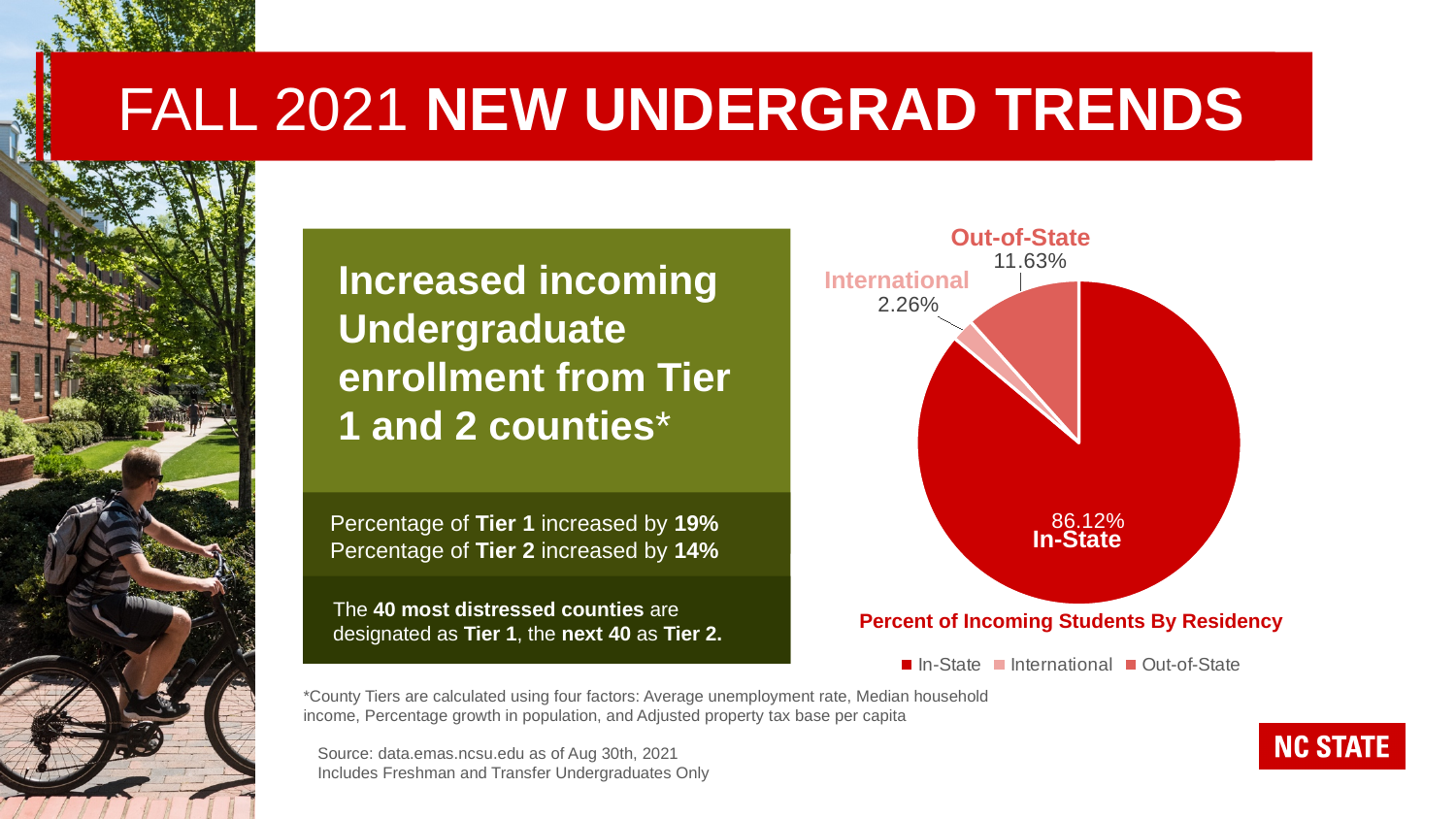
Which is larger, the Out-of-State share or the International share? Out-of-State What is the difference in percentage points between the Out-of-State and International shares? 9.37 What type of chart is shown on the slide? pie chart Which residency category has the smallest share of incoming students? International What is the difference in percentage points between the In-State and Out-of-State shares? 74.49 What percentage of incoming students are International? 2.26% What is the title of the chart? Percent of Incoming Students By Residency What percentage of incoming students are Out-of-State? 11.63% What percentage of incoming students are In-State? 86.12% Which residency category has the largest share of incoming students? In-State How many entries does the legend list? 3 How many categories does the pie chart show? 3